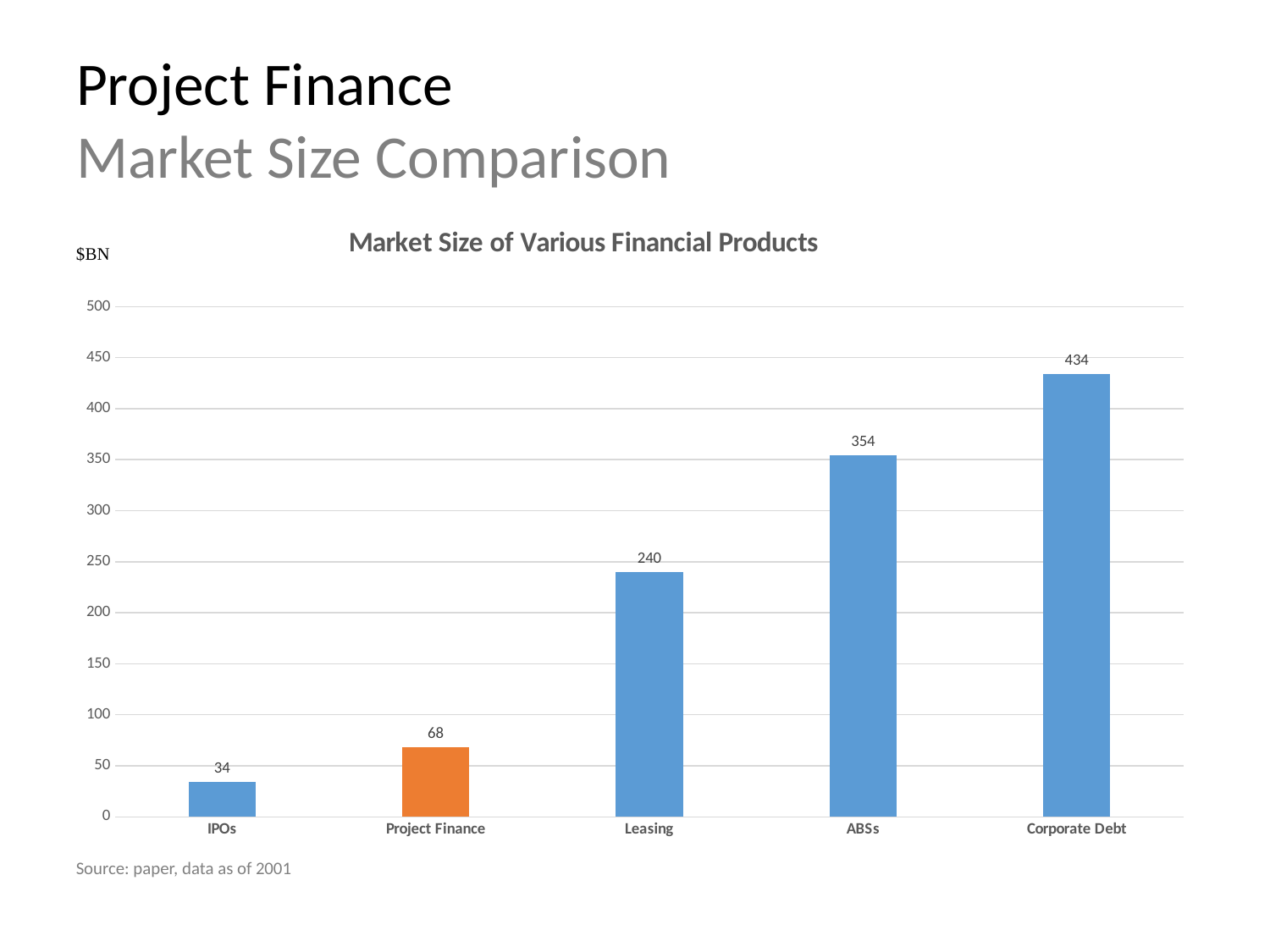
Which is larger, the value for Leasing or the value for ABSs? ABSs Is the value for Corporate Debt greater or less than 400? greater What is the value for ABSs? 354 What is the difference between the values for Corporate Debt and ABSs? 80 What is the value for Leasing? 240 Which bar is coloured orange rather than blue? Project Finance What is the value for Project Finance? 68 What is the difference between the values for Project Finance and IPOs? 34 What kind of chart is shown? bar chart Which category has the lowest value? IPOs How many categories are shown on the x axis? 5 Which category has the highest value? Corporate Debt